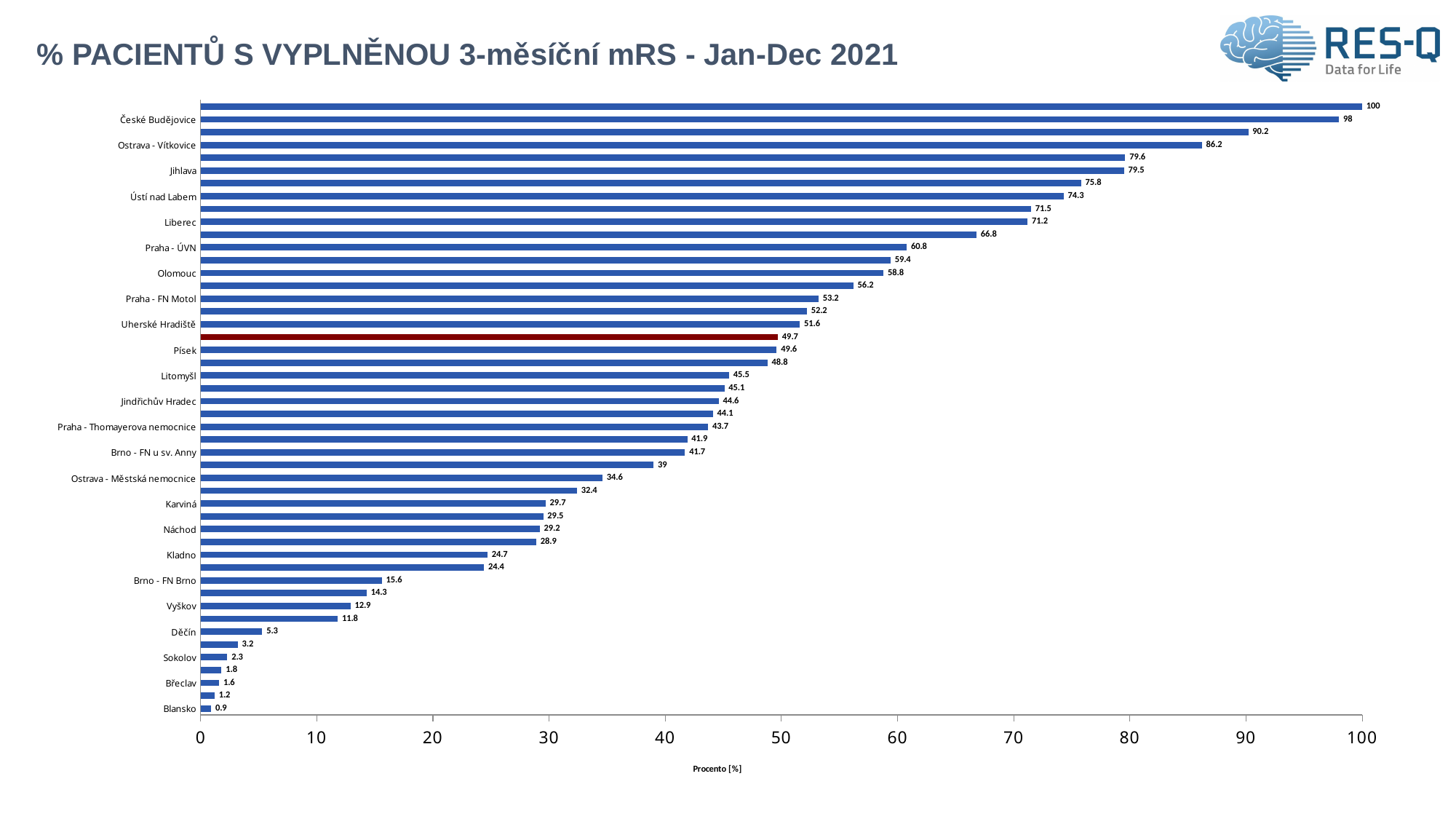
What is the value of the bar highlighted in dark red? 49.7 What is the value for Praha - FN Motol? 53.2 Which labelled category has the lowest value? Blansko What is the difference between the values for České Budějovice and Blansko? 97.1 What is the value for České Budějovice? 98 What kind of chart is shown on the slide? bar chart What is the value for Blansko? 0.9 What is the highest value shown on the chart? 100 What is the title of the x axis? Procento [%] What is the value for Jihlava? 79.5 Which has a larger value, Jihlava or Liberec? Jihlava What is the value for Kladno? 24.7